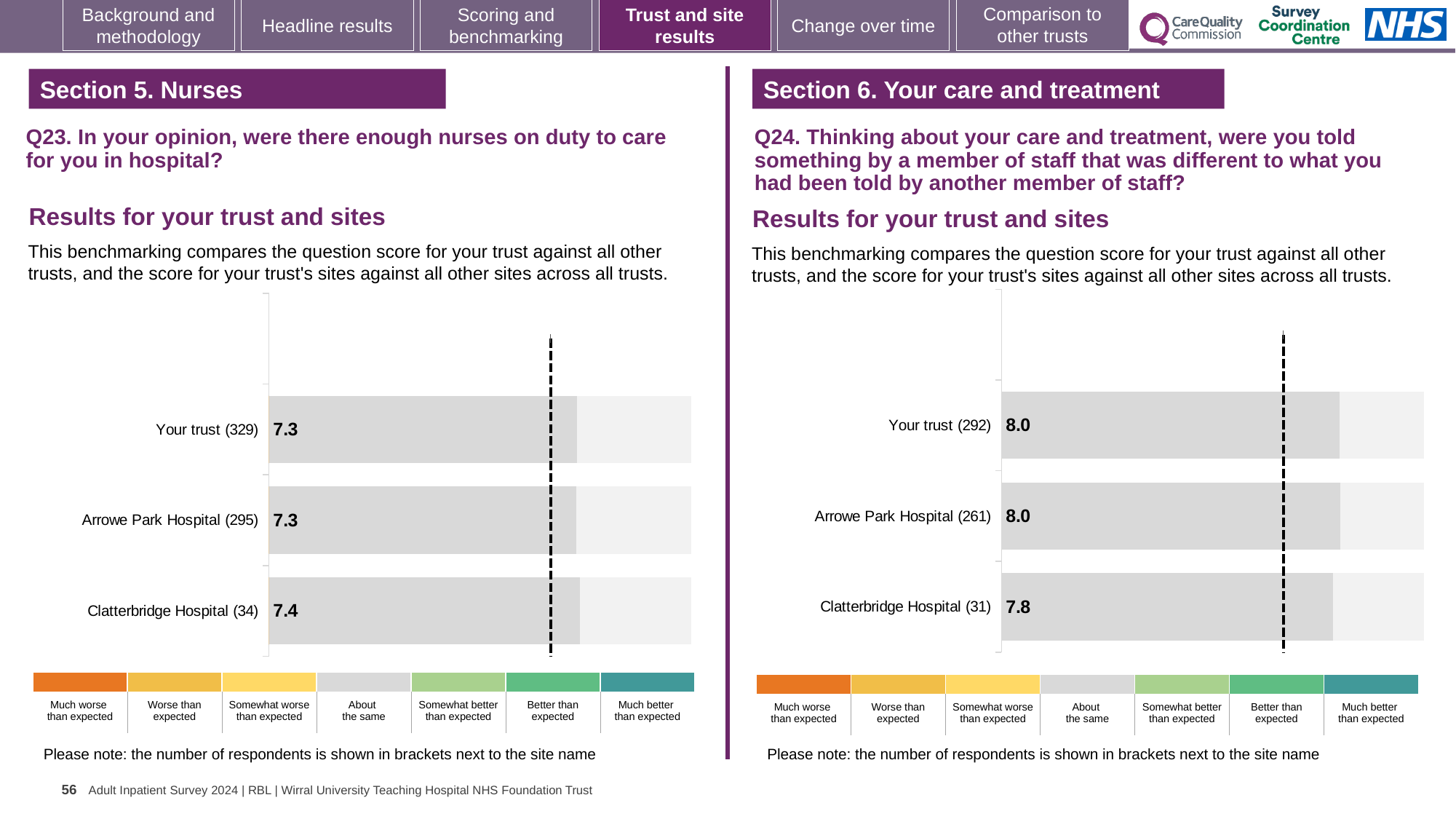
In the Q23 chart on the left, what is the score for Clatterbridge Hospital (34)? 7.4 What type of chart is used for the Q24 results on the right? Bar chart In the Q24 chart on the right, what is the difference between the score for Your trust (292) and Clatterbridge Hospital (31)? 0.2 How many bars are plotted in the Q23 chart on the left? 3 In the Q24 chart on the right, which site or trust has the lowest score? Clatterbridge Hospital (31) In the Q23 chart on the left, what is the score for Your trust (329)? 7.3 How many respondents are shown in brackets for Arrowe Park Hospital in the Q24 chart on the right? 261 In the Q23 chart on the left, which site or trust has the highest score? Clatterbridge Hospital (34) In the Q24 chart on the right, which has the larger score: Arrowe Park Hospital (261) or Clatterbridge Hospital (31)? Arrowe Park Hospital (261) In the Q23 chart on the left, what is the score for Arrowe Park Hospital (295)? 7.3 In the Q24 chart on the right, what is the score for Your trust (292)? 8.0 In the Q24 chart on the right, what is the score for Clatterbridge Hospital (31)? 7.8